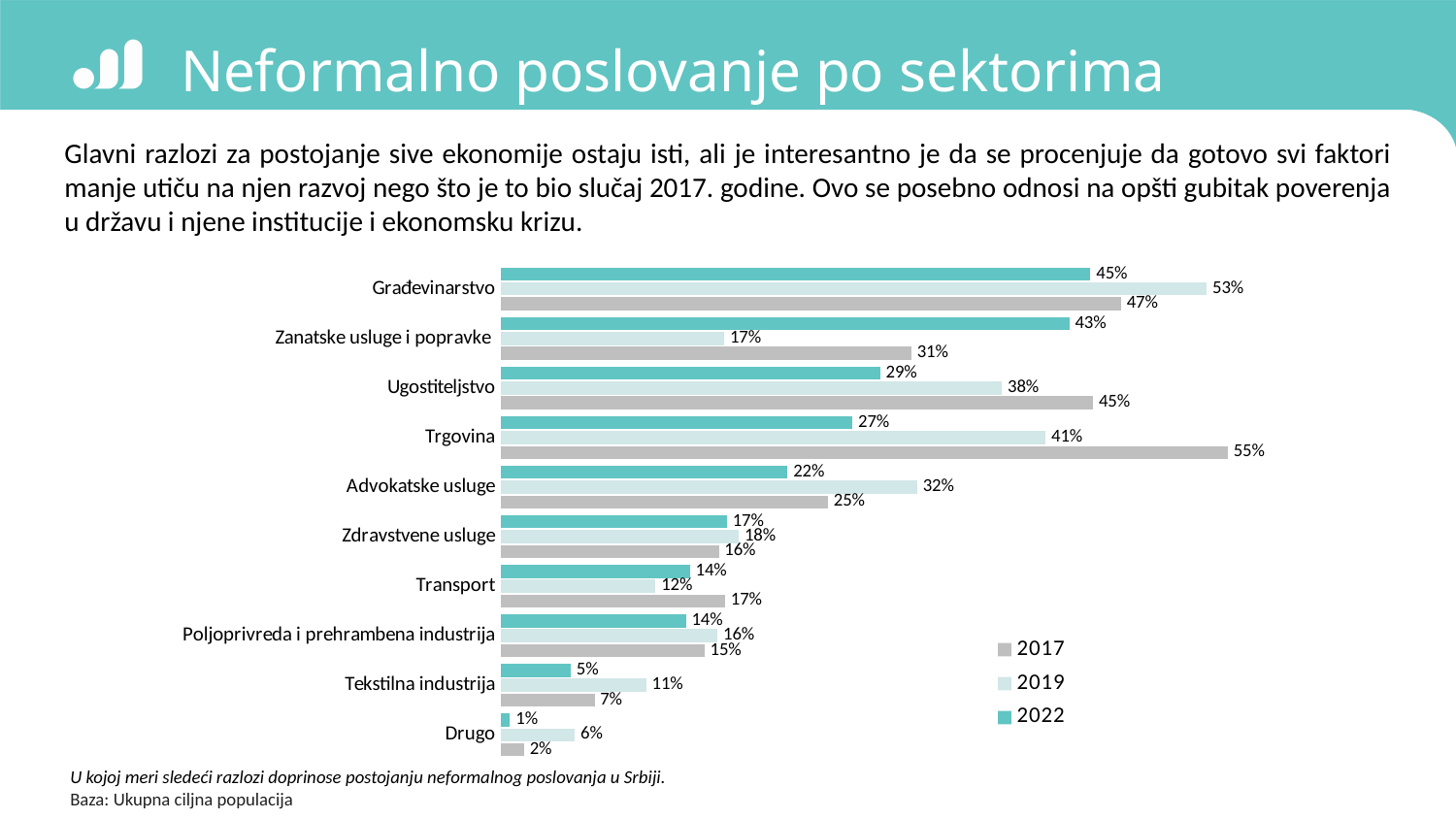
What kind of chart is shown on the slide? bar chart What is the value for Građevinarstvo in 2019? 53% Which sector has the lowest value for 2019? Drugo Which year is shown in the darkest teal colour in the legend? 2022 What is the difference between the 2019 and 2017 values for Tekstilna industrija? 4% How many series does the legend list? 3 How many sectors (categories) are shown in the chart? 10 Which is larger for Ugostiteljstvo: the 2019 value or the 2022 value? 2019 What is the value for Zanatske usluge i popravke in 2022? 43% Which sector has the highest value for 2022? Građevinarstvo What is the value for Trgovina in 2017? 55% What is the difference between the 2017 and 2022 values for Trgovina? 28%